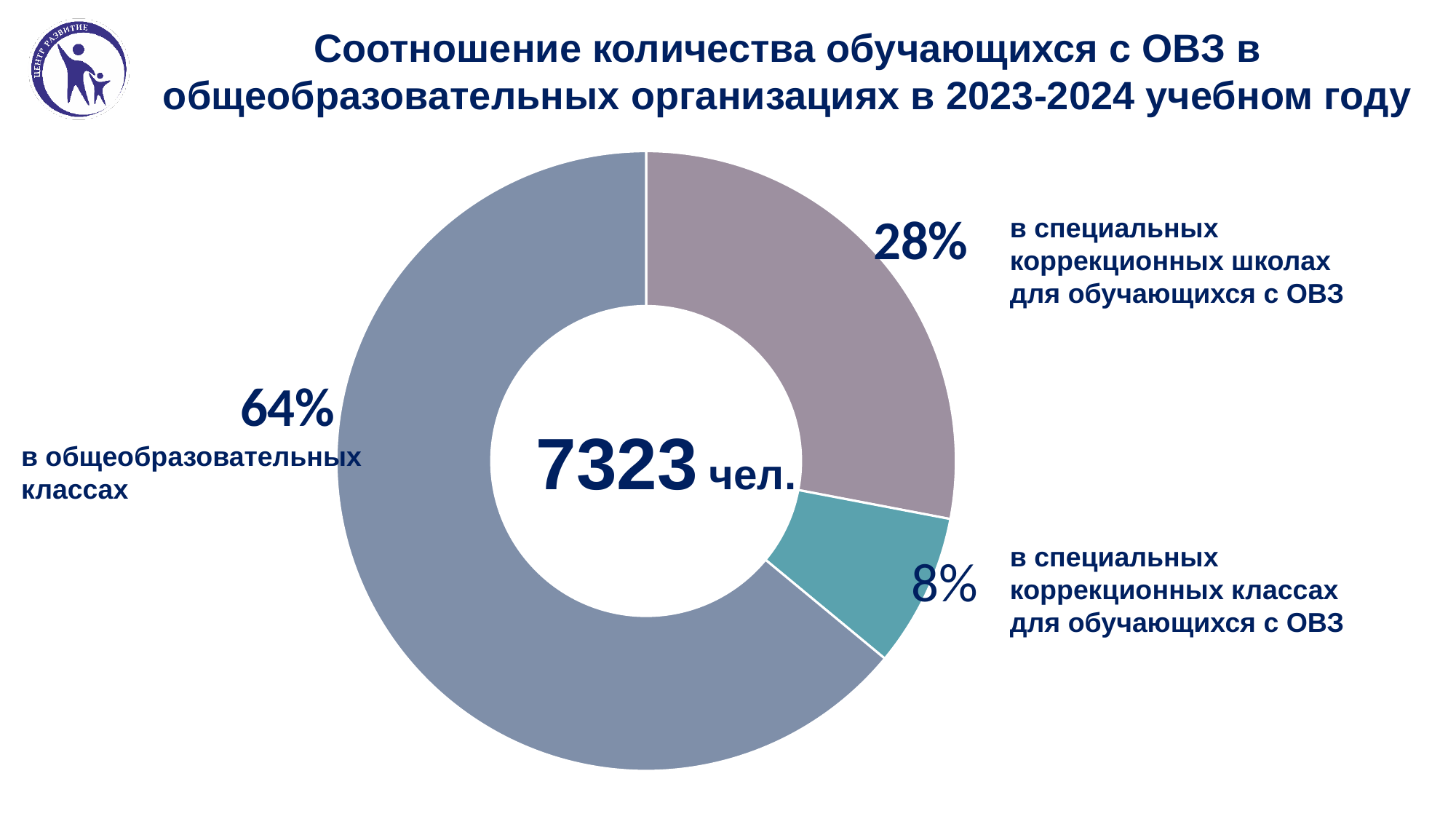
Which category has the smallest share of the pie? в специальных коррекционных классах для обучающихся с ОВЗ What share of students with disabilities are in special correctional classes (в специальных коррекционных классах)? 8% Which category has the largest share of the pie? в общеобразовательных классах How many categories (slices) does the chart show? 3 What is the title of the chart? Соотношение количества обучающихся с ОВЗ в общеобразовательных организациях в 2023-2024 учебном году What is the difference in percentage points between the share in general education classes and the share in special correctional schools? 36 What share of students with disabilities are in general education classes (в общеобразовательных классах)? 64% What kind of chart is shown on the slide? Pie chart (doughnut) What total number of people is shown in the centre of the chart? 7323 чел. Which is larger: the share in special correctional schools or the share in special correctional classes? в специальных коррекционных школах What is the difference in percentage points between the share in special correctional schools and the share in special correctional classes? 20 What share of students with disabilities are in special correctional schools (в специальных коррекционных школах)? 28%